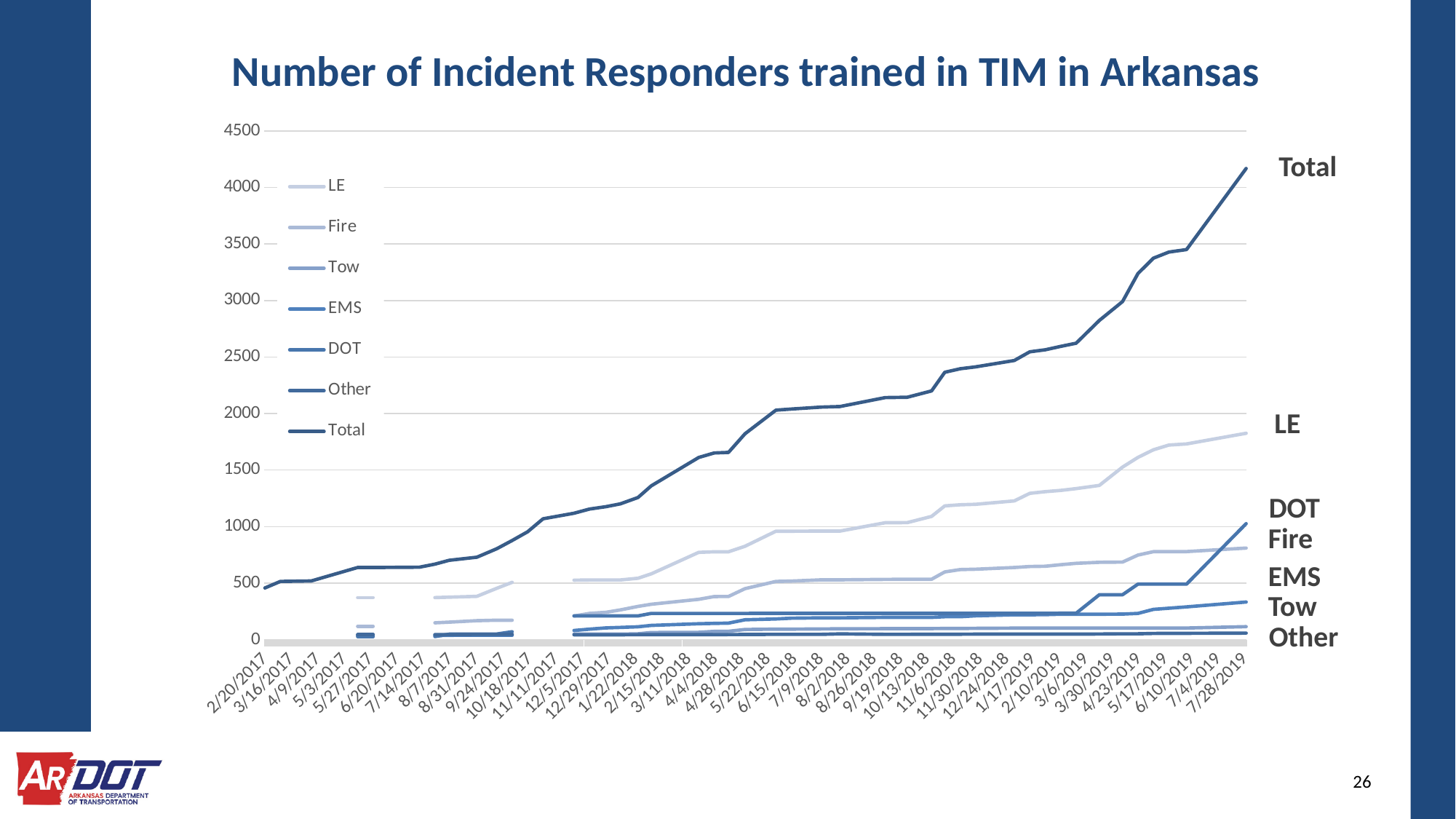
Which series has the lowest value at 7/28/2019? Other Is the value of the Fire line at 7/28/2019 greater or less than 1000? less Is the value of the Total line at 7/28/2019 greater or less than 4000? greater Is the value of the Total line at 2/20/2017 greater or less than 500? less What is the title of the chart? Number of Incident Responders trained in TIM in Arkansas What kind of chart is shown on the slide? Line chart Which series has the highest value at 7/28/2019? Total How many series does the legend list? 7 At 7/28/2019, which is larger: LE or Fire? LE Does the Total line rise or fall from 2/20/2017 to 7/28/2019? Rises